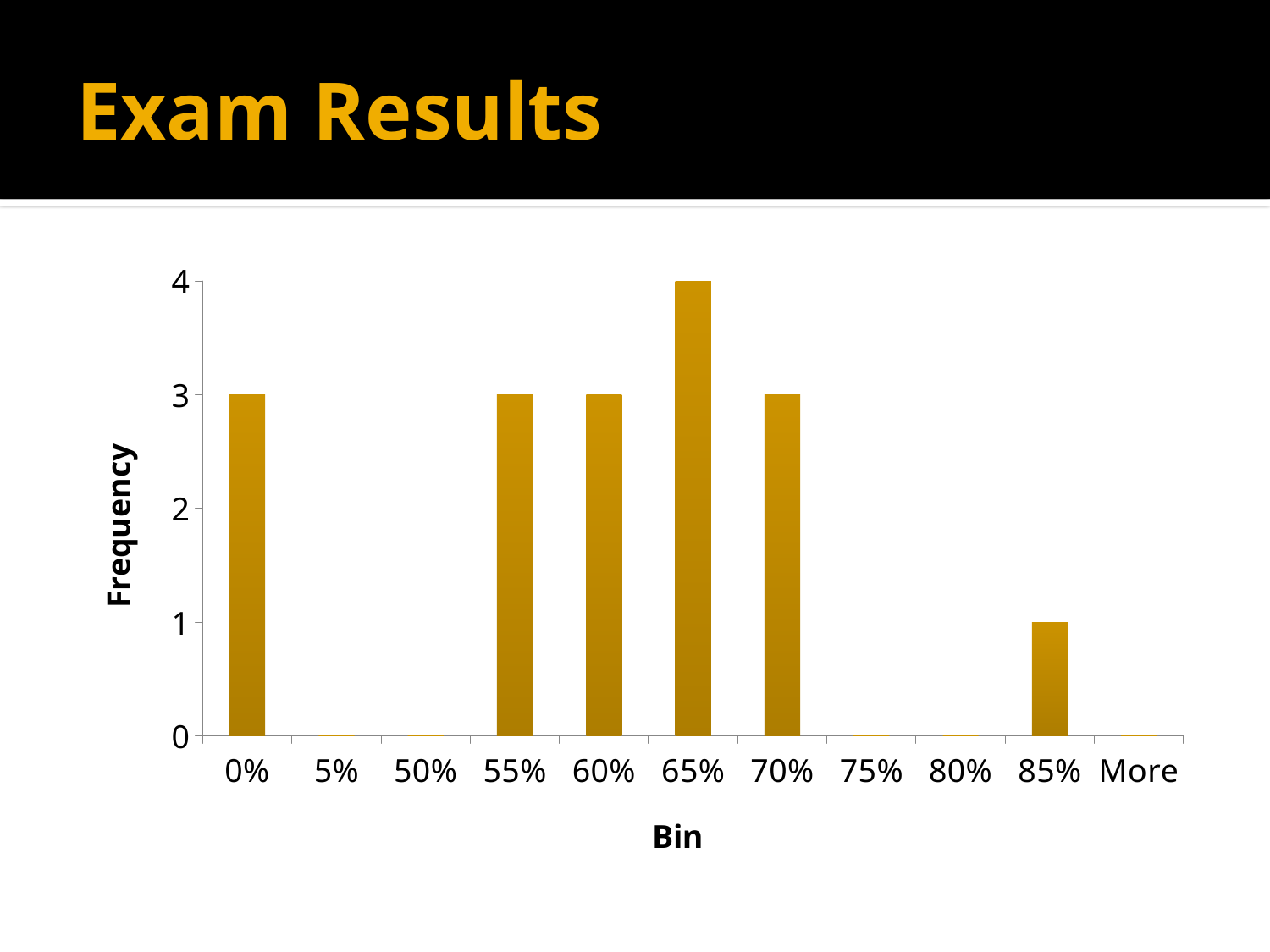
What is the frequency for the 0% bin? 3 What is the frequency for the 60% bin? 3 What is the frequency for the 85% bin? 1 What is the label of the y axis? Frequency Which bin has the highest frequency? 65% What is the frequency for the 65% bin? 4 Among the bins that have a bar, which has the lowest frequency? 85% What kind of chart is shown on the slide? Bar chart Which bin has a higher frequency, 70% or 85%? 70% What is the difference in frequency between the 65% bin and the 85% bin? 3 How many bins are labelled on the x axis? 11 How many bins have a visible bar? 6